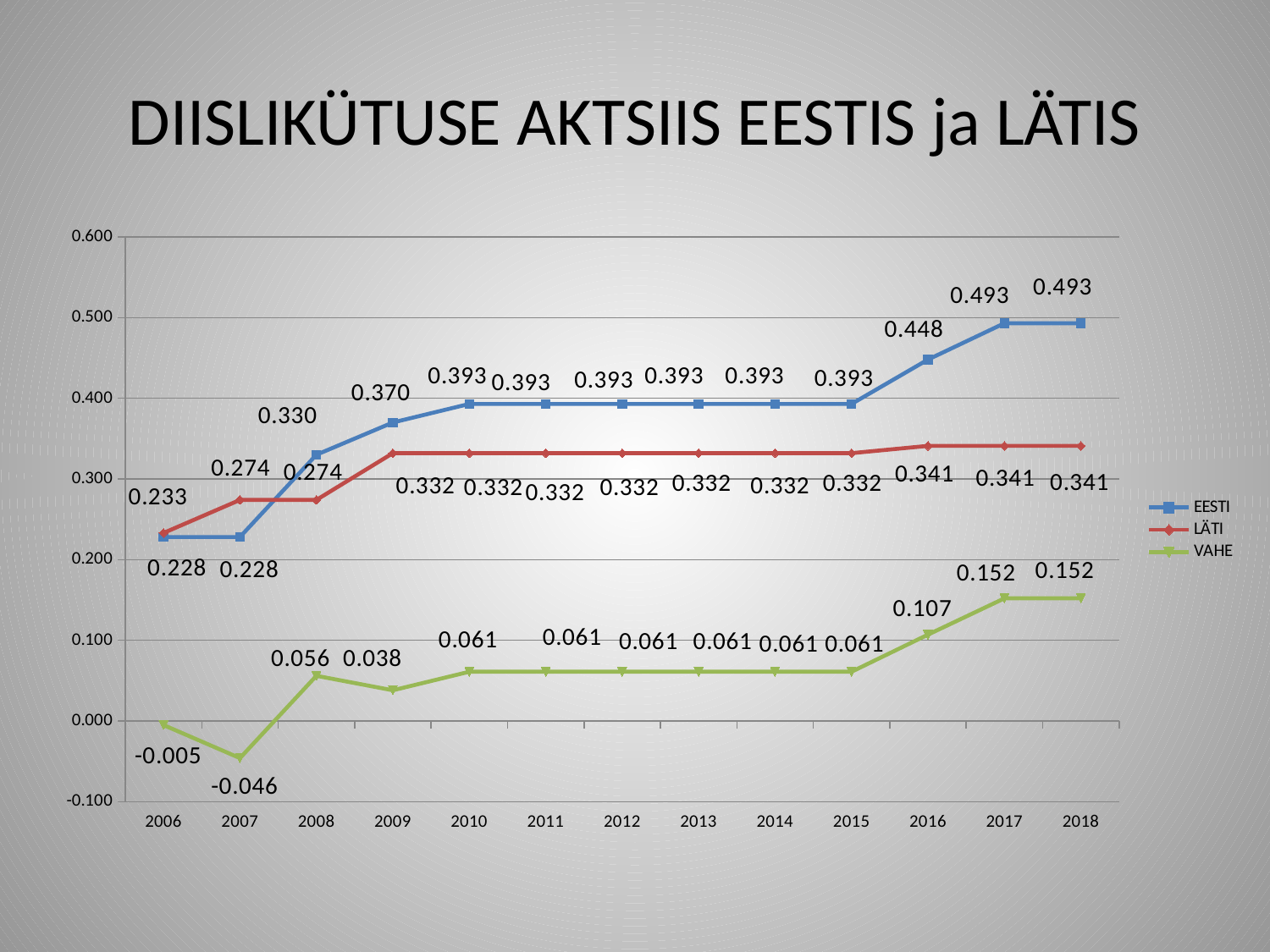
What is the value for EESTI in 2016? 0.448 How many years are shown on the x axis? 13 Does the EESTI series generally rise or fall from 2006 to 2018? rise What type of chart is shown on the slide? line chart What is the title of the chart on the slide? DIISLIKÜTUSE AKTSIIS EESTIS ja LÄTIS How many series does the legend list? 3 In which year does the VAHE series reach its lowest value? 2007 Which series has the larger value in 2006, EESTI or LÄTI? LÄTI What is the value for VAHE in 2007? -0.046 What is the value for LÄTI in 2007? 0.274 What is the highest value shown for the EESTI series? 0.493 What is the difference between the EESTI value and the LÄTI value in 2018? 0.152